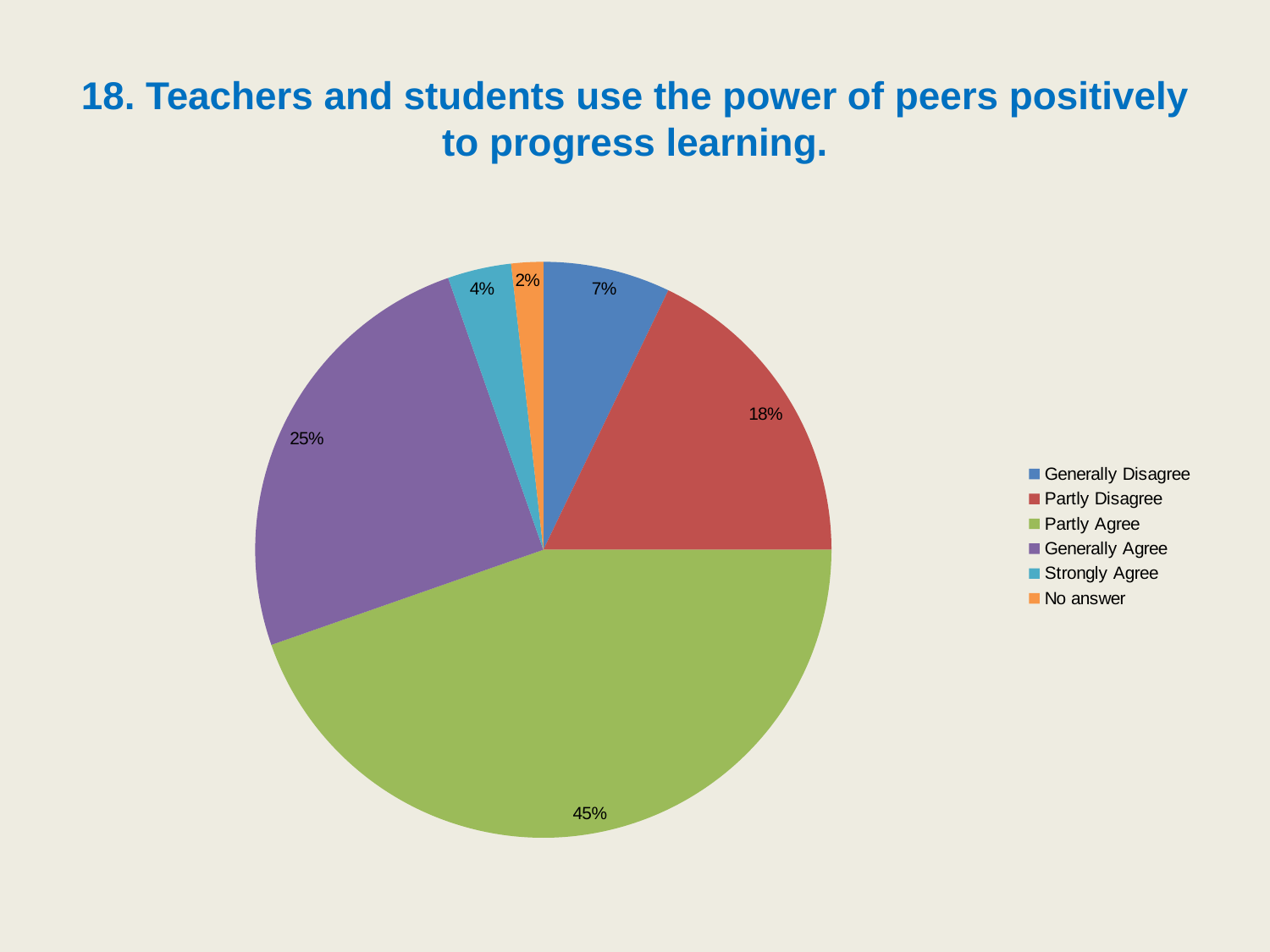
What kind of chart is shown on the slide? pie chart What percentage of respondents gave No answer? 2% Which response category has the smallest share of the pie? No answer What is the difference in percentage points between Partly Agree and Generally Agree? 20 How many categories does the legend list? 6 What percentage of respondents chose Generally Disagree? 7% Which is larger, the share for Partly Disagree or the share for Generally Disagree? Partly Disagree What percentage of respondents chose Partly Disagree? 18% What percentage of respondents chose Partly Agree? 45% Which response category has the largest share of the pie? Partly Agree What percentage of respondents chose Generally Agree? 25% What percentage of respondents chose Strongly Agree? 4%